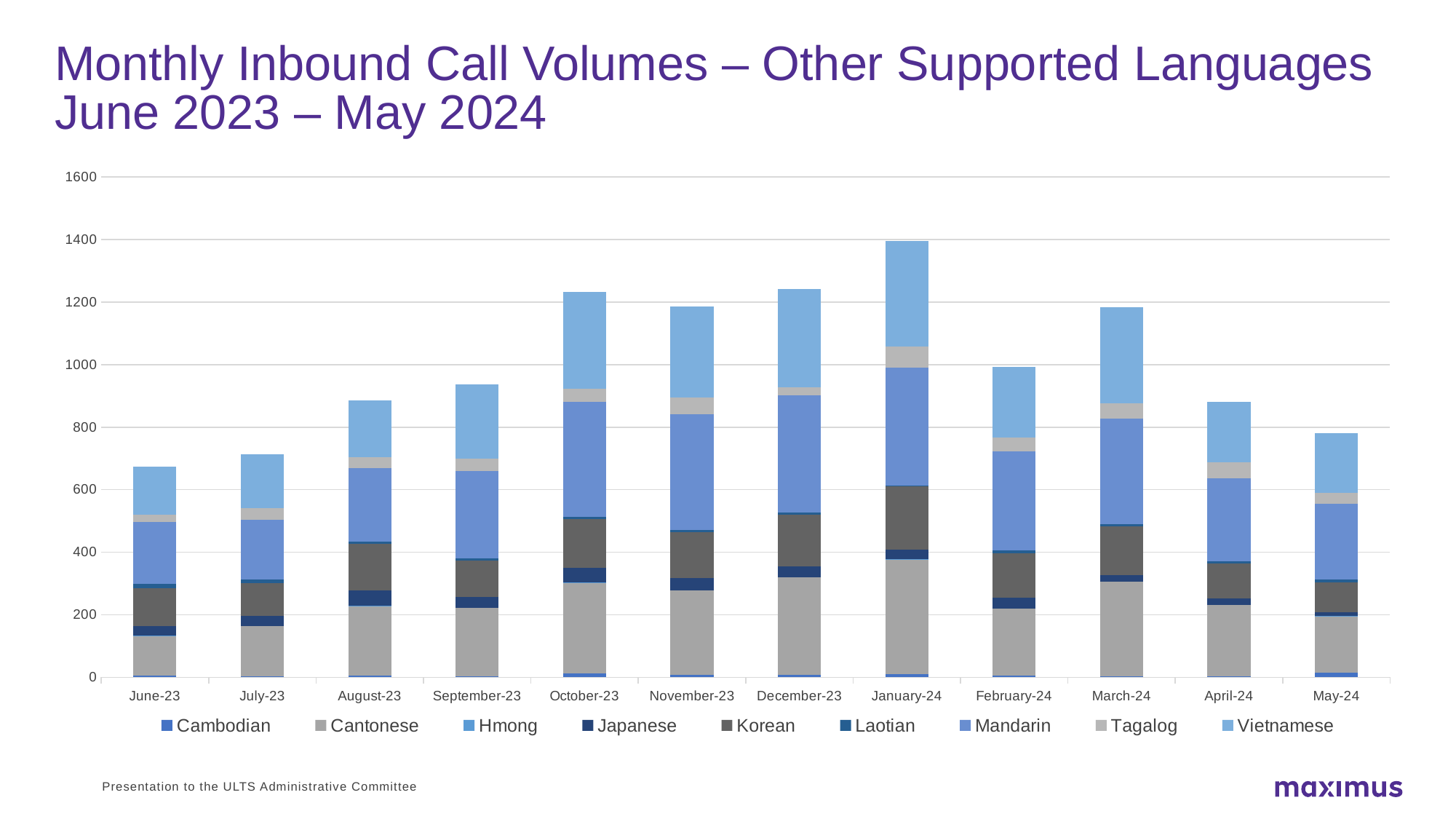
Is the total call volume for March-24 greater or less than 1000? greater What kind of chart is shown on the slide? Stacked bar chart What is the title of the chart on the slide? Monthly Inbound Call Volumes – Other Supported Languages June 2023 – May 2024 Is the total call volume for January-24 greater or less than 1200? greater Is the total call volume for September-23 greater or less than 1000? less Which month has the highest total inbound call volume? January-24 How many months are shown along the x axis of the chart? 12 Which month has the lowest total inbound call volume? June-23 How many languages (series) does the legend list? 9 Do the total monthly call volumes rise or fall from June-23 to October-23? rise Which month has a larger total call volume, January-24 or February-24? January-24